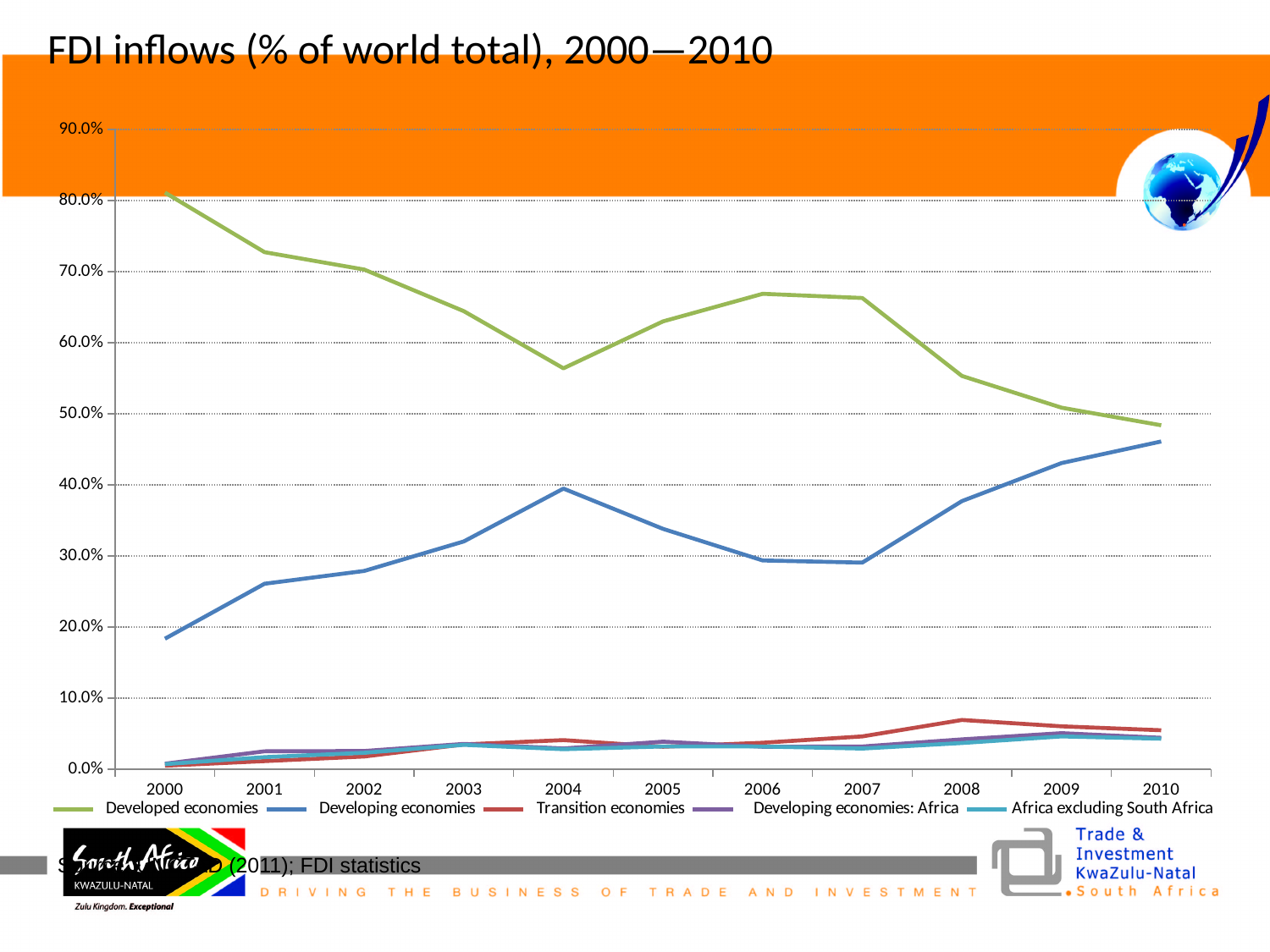
In which year is the value for Developed economies highest? 2000 How many series does the legend list? 5 What kind of chart is shown on the slide? line chart Is the value for Transition economies in 2008 greater or less than 10.0%? less In which year is the value for Developing economies lowest? 2000 Is the value for Developed economies in 2000 greater or less than 80.0%? greater Is the value for Developing economies in 2000 greater or less than 20.0%? less In 2004, which is larger: the value for Developed economies or for Developing economies? Developed economies Does the value for Developed economies rise or fall overall from 2000 to 2010? fall How many years are plotted along the x axis? 11 In which year is the value for Developing economies highest? 2010